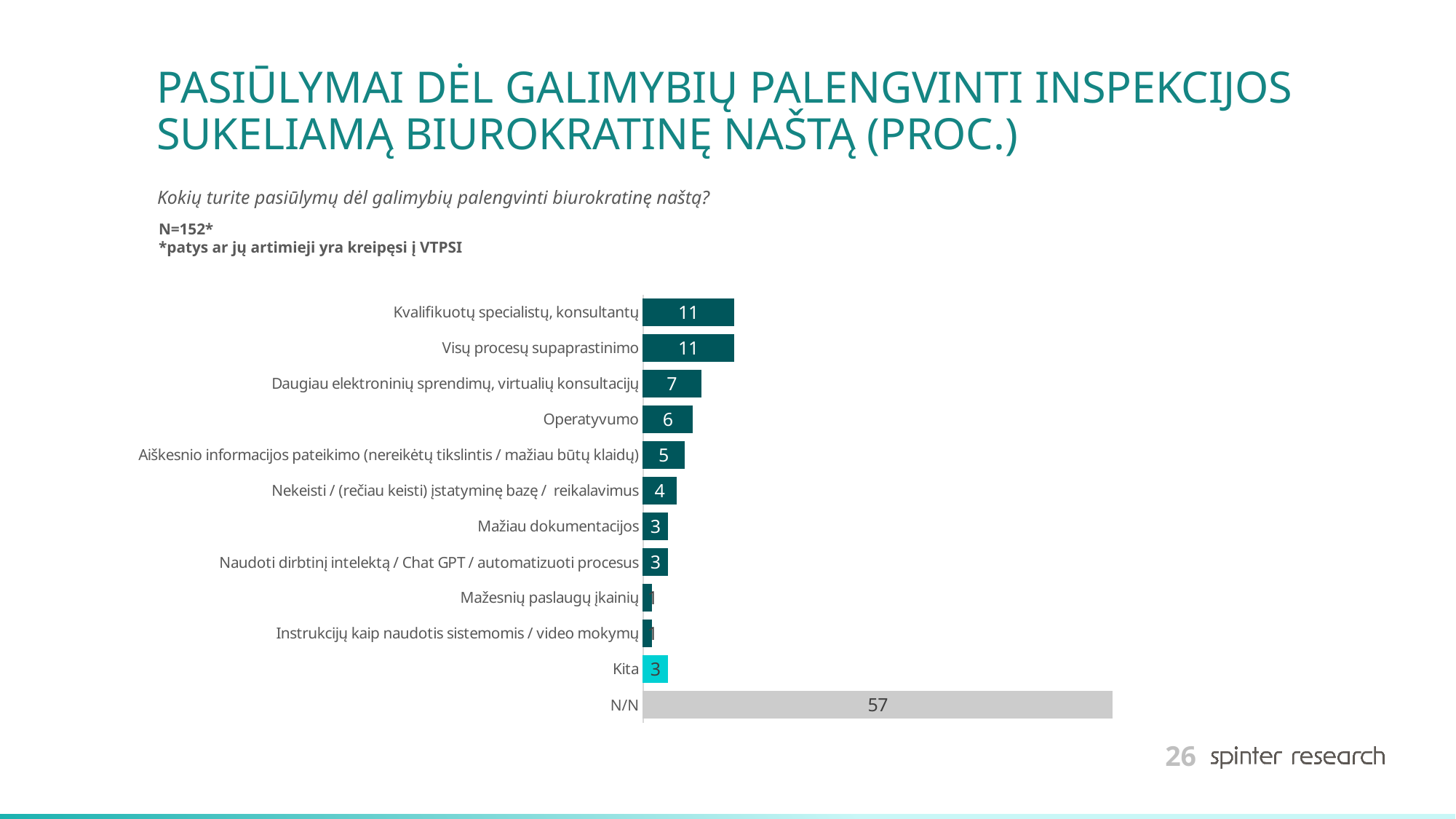
What is the value for "Kita"? 3 What is the difference between the value for "N/N" and the value for "Kvalifikuotų specialistų, konsultantų"? 46 What is the difference between the value for "Aiškesnio informacijos pateikimo (nereikėtų tikslintis / mažiau būtų klaidų)" and the value for "Mažiau dokumentacijos"? 2 What kind of chart is shown on the slide? bar chart What is the sample size (N) stated on the slide? 152 What is the value for "Operatyvumo"? 6 Which is larger: the value for "Operatyvumo" or the value for "Nekeisti / (rečiau keisti) įstatyminę bazę / reikalavimus"? Operatyvumo What is the value for "N/N"? 57 What is the value for "Visų procesų supaprastinimo"? 11 Which category has the highest value? N/N How many categories are shown in the chart? 12 What is the value for "Daugiau elektroninių sprendimų, virtualių konsultacijų"? 7